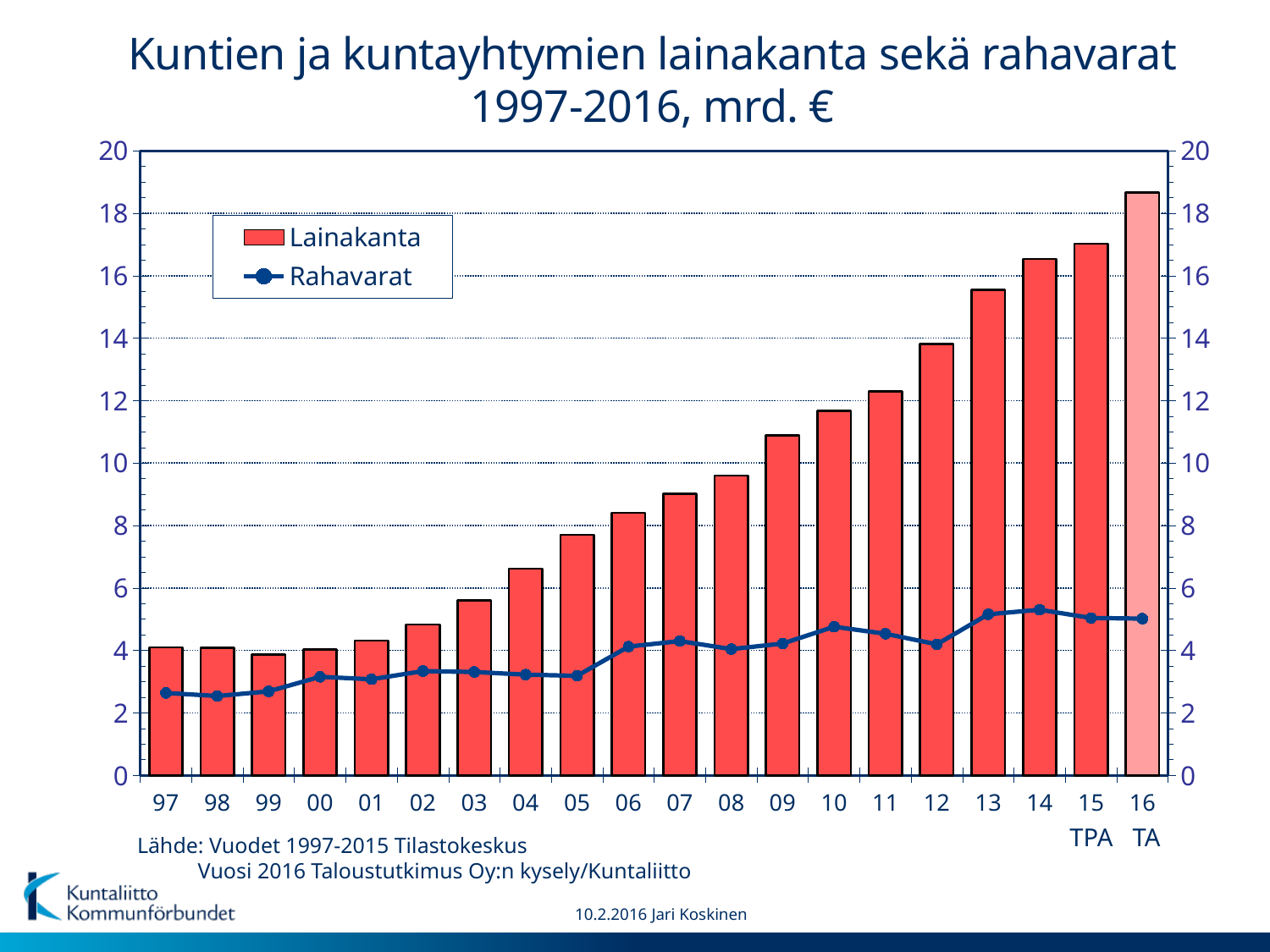
Is the Lainakanta value for 05 greater or less than 8? less Is the Lainakanta value for 16 greater or less than 18? greater Is the Rahavarat value for 97 greater or less than 4? less Which is larger, the Lainakanta value for 13 or for 10? 13 How many years are shown on the x axis? 20 How many series does the legend list? 2 Which year has the highest Lainakanta bar? 16 Does the Lainakanta series generally rise or fall from 97 to 16? rise What kind of chart is shown on the slide? A combined bar and line chart Which series is drawn as a line with markers? Rahavarat